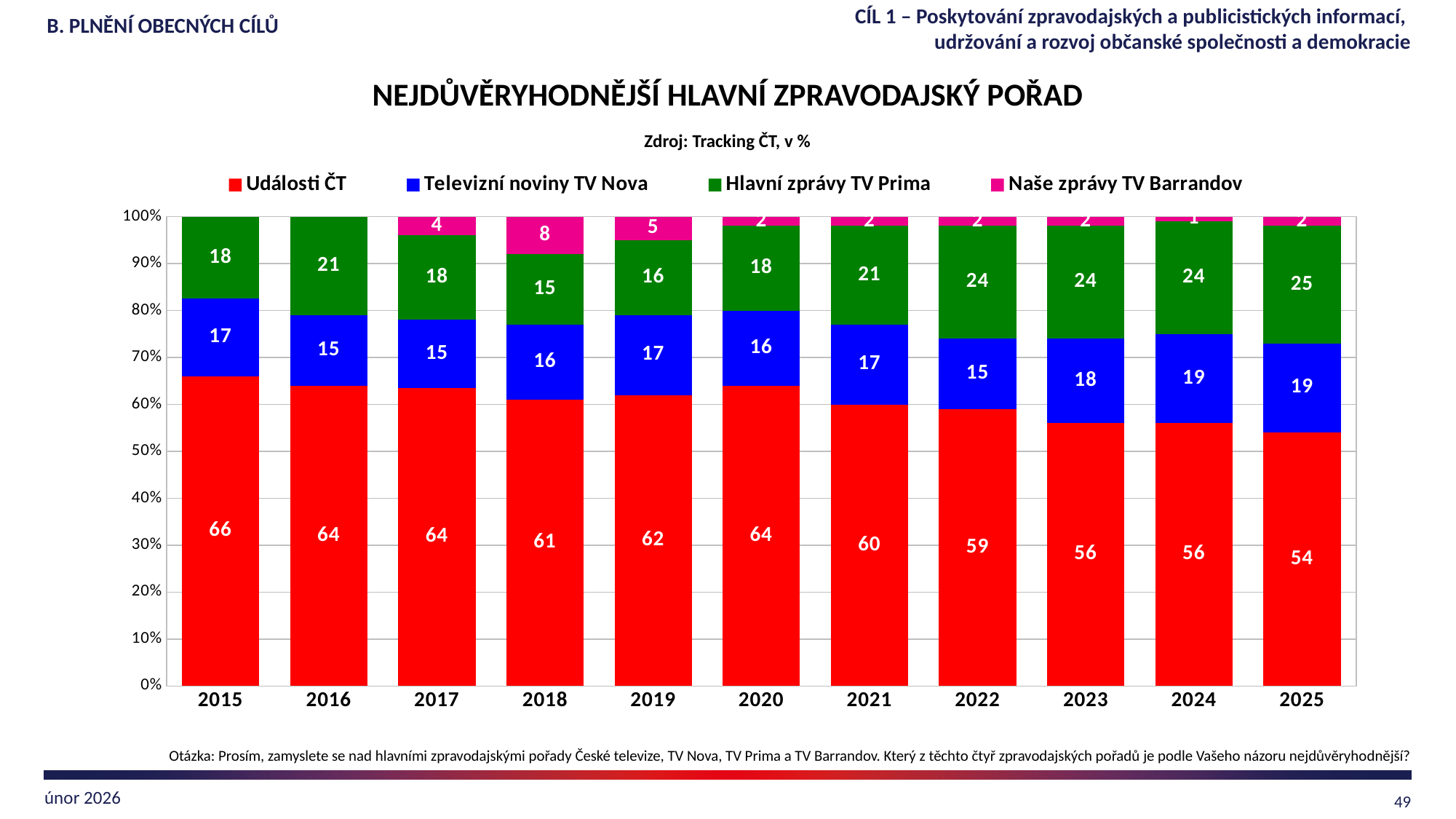
What is the value for Události ČT in 2015? 66 Which is larger in 2022: the value for Televizní noviny TV Nova or the value for Hlavní zprávy TV Prima? Hlavní zprávy TV Prima In which year is the value for Naše zprávy TV Barrandov the highest? 2018 What is the difference between the Události ČT values in 2015 and 2025? 12 What is the total of the stacked bar for 2025? 100 What is the value for Naše zprávy TV Barrandov in 2018? 8 In which year is the value for Události ČT the lowest? 2025 What is the value for Hlavní zprávy TV Prima in 2025? 25 How many series does the legend list? 4 How many years are shown on the x axis? 11 What kind of chart is shown on the slide? Stacked bar chart Does the value for Události ČT generally rise or fall from 2015 to 2025? Fall